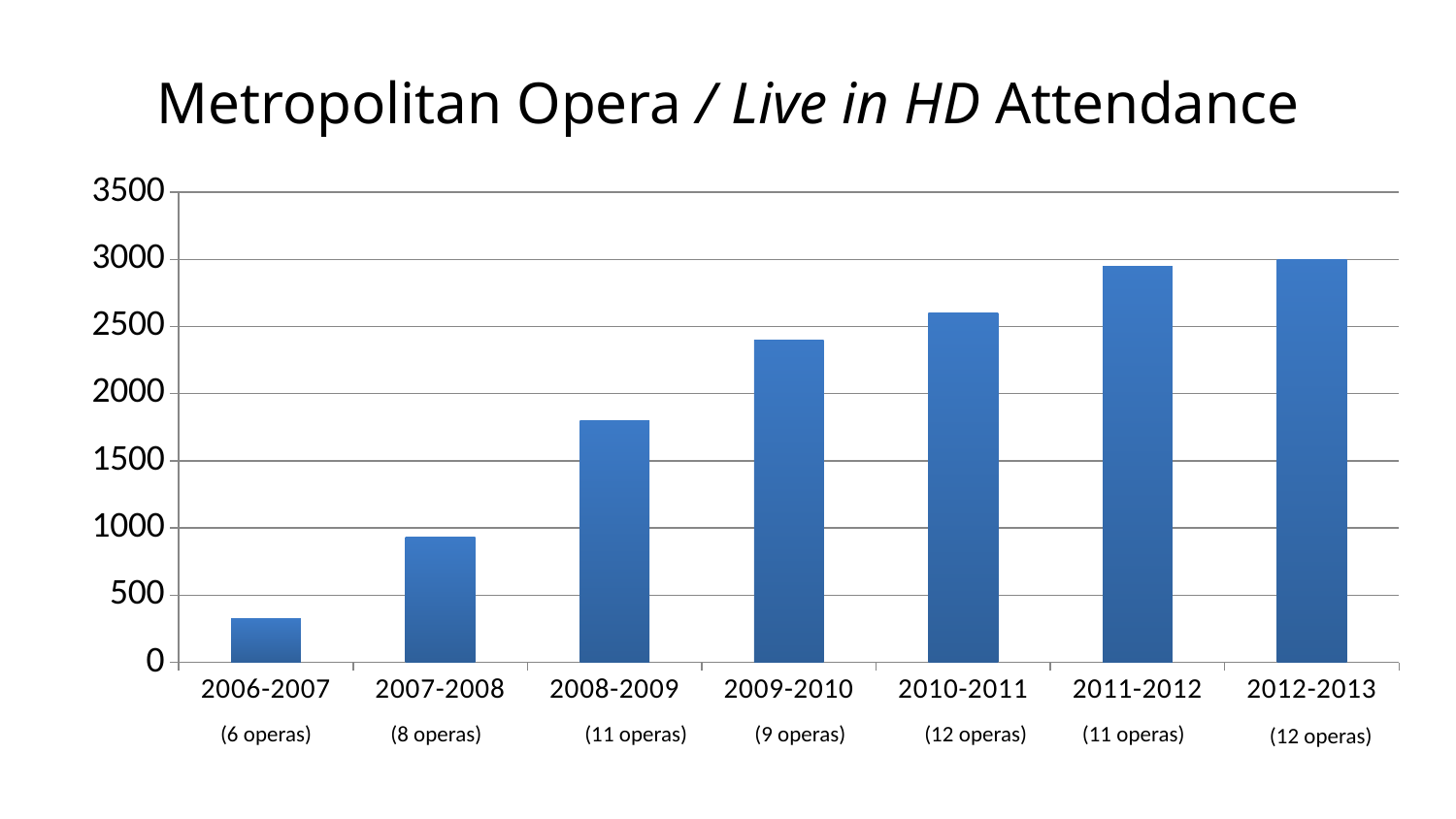
Is the attendance for 2009-2010 greater or less than 2500? less Is the attendance for 2010-2011 greater or less than 2500? greater Is the attendance for 2007-2008 greater or less than 1000? less Which season has the lowest attendance? 2006-2007 Do attendance values generally rise or fall from 2006-2007 to 2012-2013? rise How many seasons are plotted on the chart? 7 What is the title of the chart? Metropolitan Opera / Live in HD Attendance What kind of chart is shown on the slide? bar chart Which season has higher attendance, 2009-2010 or 2010-2011? 2010-2011 Which season has higher attendance, 2007-2008 or 2008-2009? 2008-2009